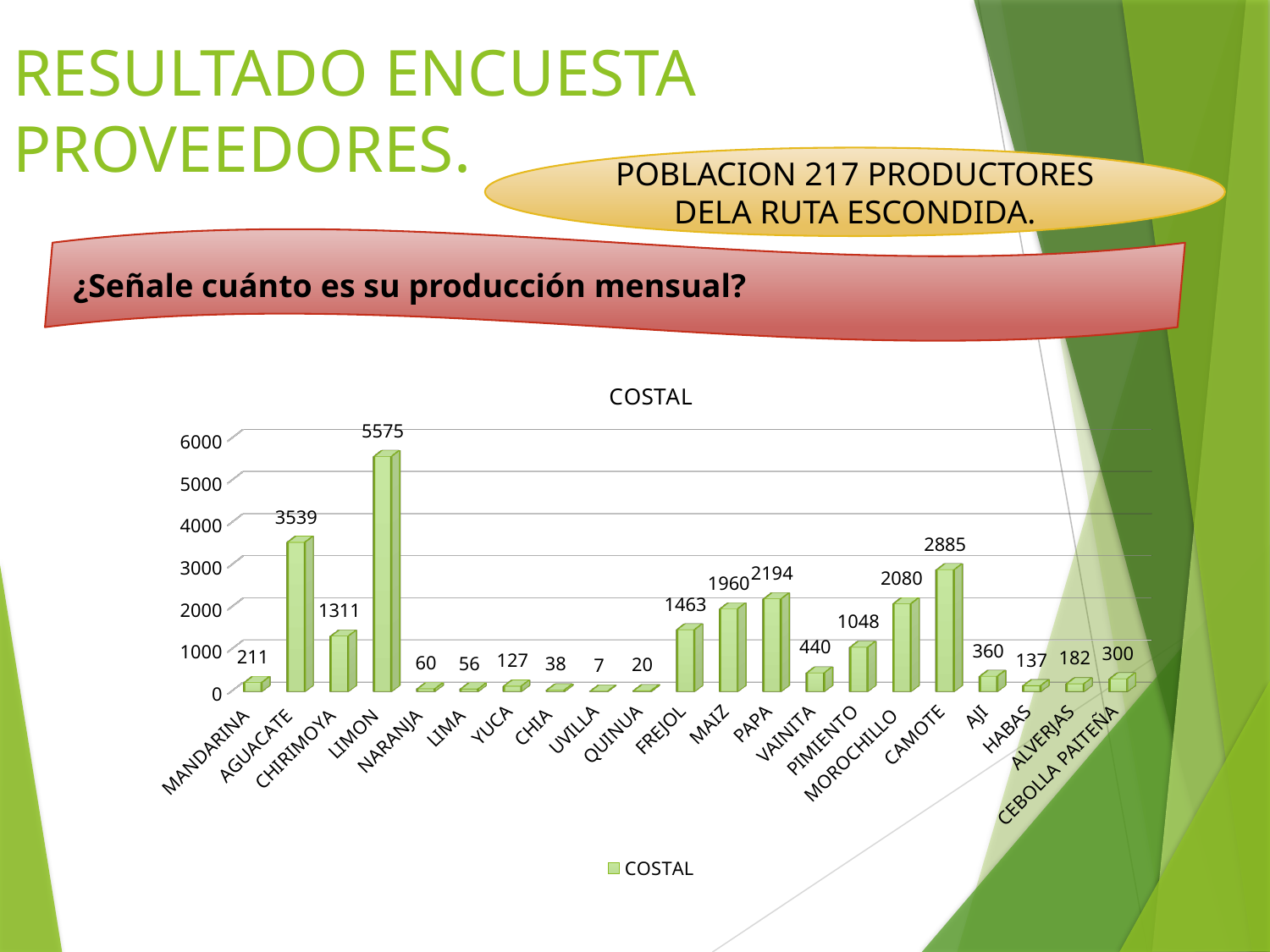
What is the value for PIMIENTO in the COSTAL chart? 1048 How many categories are shown in the COSTAL chart? 21 What is the difference between the values for LIMON and AGUACATE? 2036 What kind of chart is shown on the slide? bar chart What is the difference between the values for CAMOTE and PAPA? 691 Which has a larger value, AGUACATE or CAMOTE? AGUACATE How many series does the legend list? 1 Is the value for CHIRIMOYA greater or less than 2000? less What is the value for LIMON in the COSTAL chart? 5575 What is the value for CEBOLLA PAITEÑA in the COSTAL chart? 300 Which category has the highest value in the COSTAL chart? LIMON Which category has the lowest value in the COSTAL chart? UVILLA